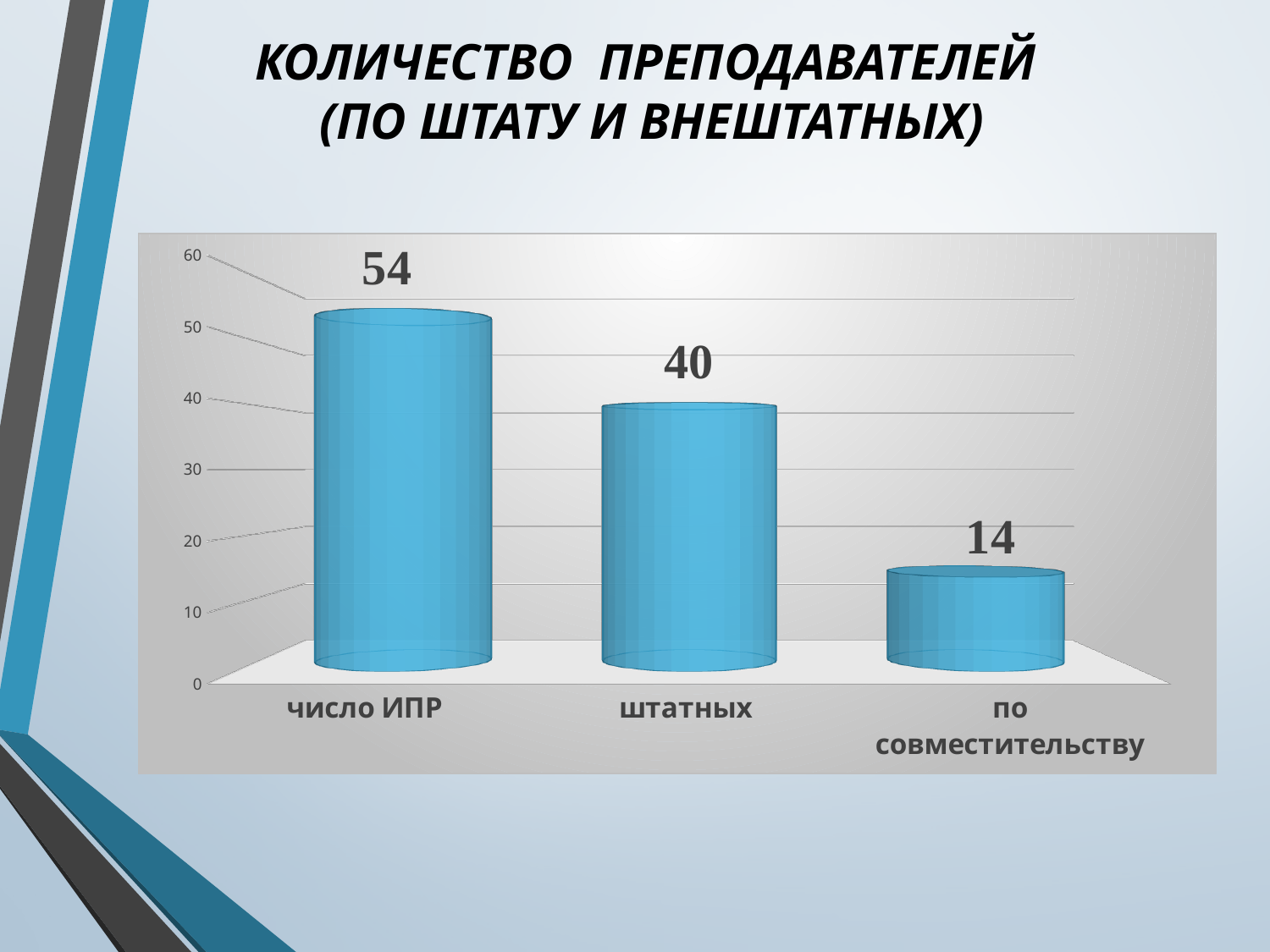
Do the values rise or fall from left to right along the x axis? fall Which category has the highest value? число ИПР Which is larger, the value for штатных or the value for по совместительству? штатных What is the value for штатных? 40 What is the value for число ИПР? 54 What is the difference between the values for число ИПР and штатных? 14 What is the value for по совместительству? 14 How many categories are shown on the x axis? 3 Which category has the lowest value? по совместительству What kind of chart is shown on the slide? bar chart Is the value for число ИПР greater or less than 50? greater What is the difference between the values for штатных and по совместительству? 26